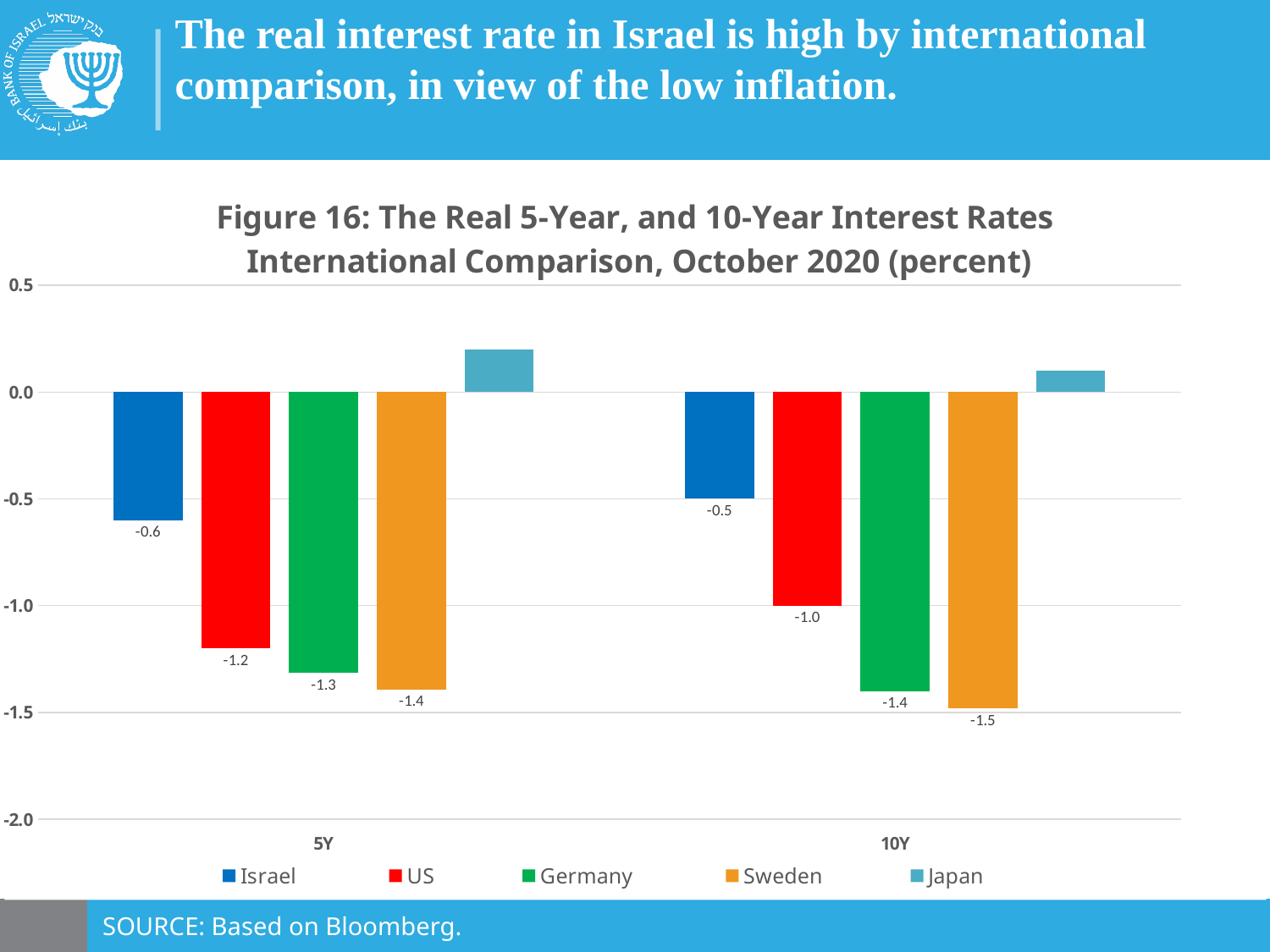
What is the value for Sweden in the 10Y group? -1.5 Which country has the lowest real interest rate in the 10Y group? Sweden Which country has the highest real interest rate in the 5Y group? Japan What kind of chart is shown on the slide? Bar chart Is the value for Japan in the 5Y group greater or less than 0.0? greater What is the source given for the chart? Based on Bloomberg What is the value for Germany in the 5Y group? -1.3 How many series does the legend list? 5 What is the real 10-year interest rate for the US? -1.0 What is the real 5-year interest rate for Israel? -0.6 What is the difference between the 5Y values for Israel and the US? 0.6 In the 10Y group, which is larger, the value for Israel or the value for Germany? Israel